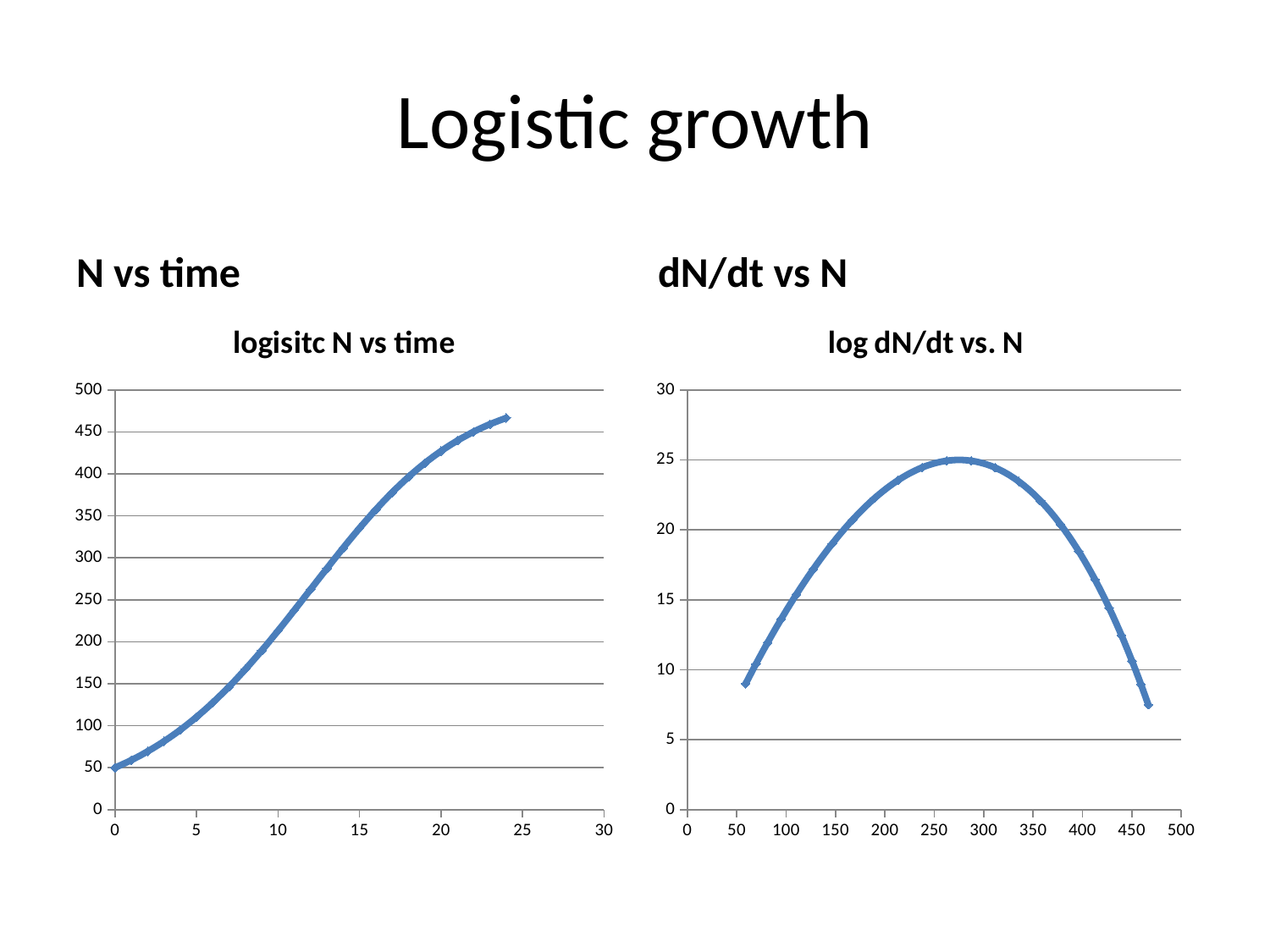
In the right chart "log dN/dt vs. N", how do the values change as N increases along the x axis? rise then fall In the left chart "logisitc N vs time", is the value at time 20 greater or less than 400? greater What kind of chart is the left chart titled "logisitc N vs time"? line chart In the right chart "log dN/dt vs. N", is the highest value on the curve greater or less than 30? less In the left chart "logisitc N vs time", is the final value at time 24 greater or less than 500? less What kind of chart is the right chart titled "log dN/dt vs. N"? line chart What is the title of the chart on the left side of the slide? logisitc N vs time In the left chart "logisitc N vs time", do the values rise or fall as time increases along the x axis? rise What is the highest tick value shown on the x axis of the right chart "log dN/dt vs. N"? 500